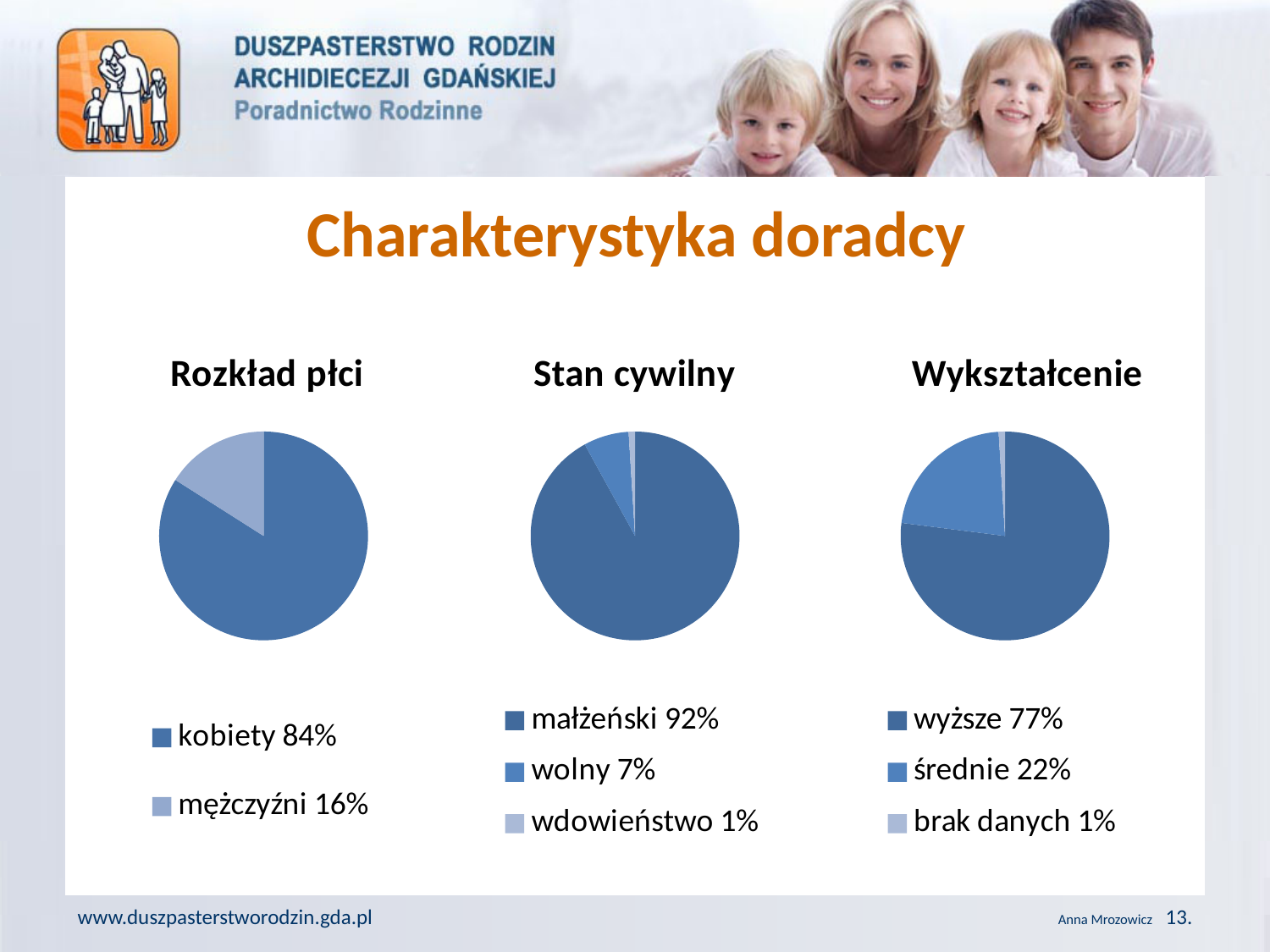
In the 'Rozkład płci' chart, what share is shown for mężczyźni? 16% In the 'Rozkład płci' chart, what share is shown for kobiety? 84% How many categories does the 'Stan cywilny' chart show? 3 In the 'Rozkład płci' chart, what is the difference in percentage points between kobiety and mężczyźni? 68 What is the title of the chart on the right of the slide? Wykształcenie In the 'Stan cywilny' chart, what share is shown for wolny? 7% In the 'Stan cywilny' chart, what share is shown for małżeński? 92% In the 'Wykształcenie' chart, which is larger: średnie or brak danych? średnie What kind of chart is the 'Rozkład płci' chart? pie chart In the 'Stan cywilny' chart, which category has the smallest share? wdowieństwo In the 'Wykształcenie' chart, what share is shown for średnie? 22% In the 'Wykształcenie' chart, which category has the largest share? wyższe